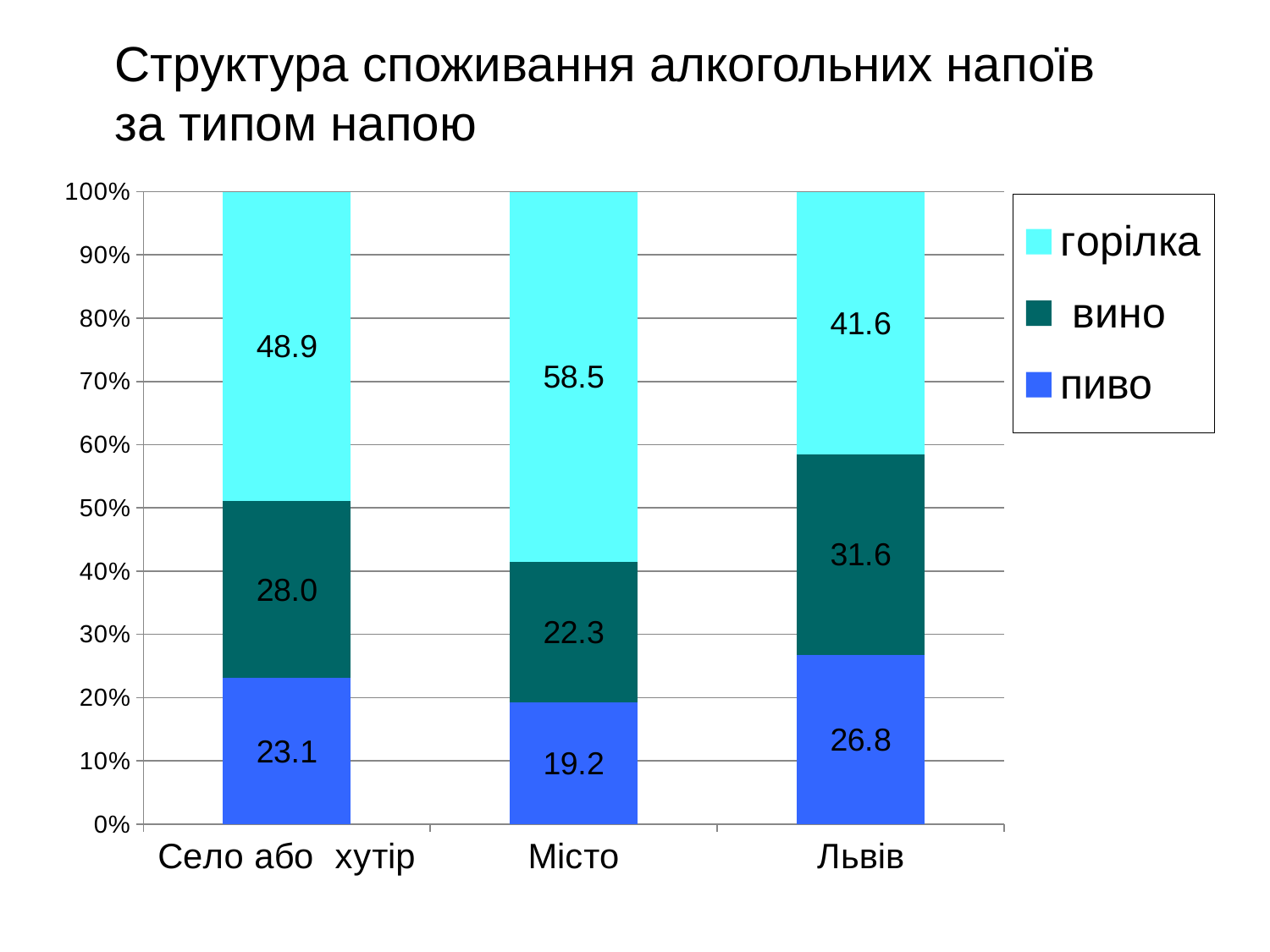
What is the value for горілка in Місто? 58.5 How many categories are shown on the x axis? 3 What is the title of the chart? Структура споживання алкогольних напоїв за типом напою Which series is shown in the lightest (cyan) colour? горілка What is the difference between the вино values for Львів and Місто? 9.3 Which category has the highest value for горілка? Місто What kind of chart is shown on the slide? Stacked bar chart What is the value for пиво in Львів? 26.8 How many series does the legend list? 3 Which category has the lowest value for пиво? Місто What is the value for вино in Село або хутір? 28.0 Which is larger: the пиво value for Село або хутір or for Львів? Львів